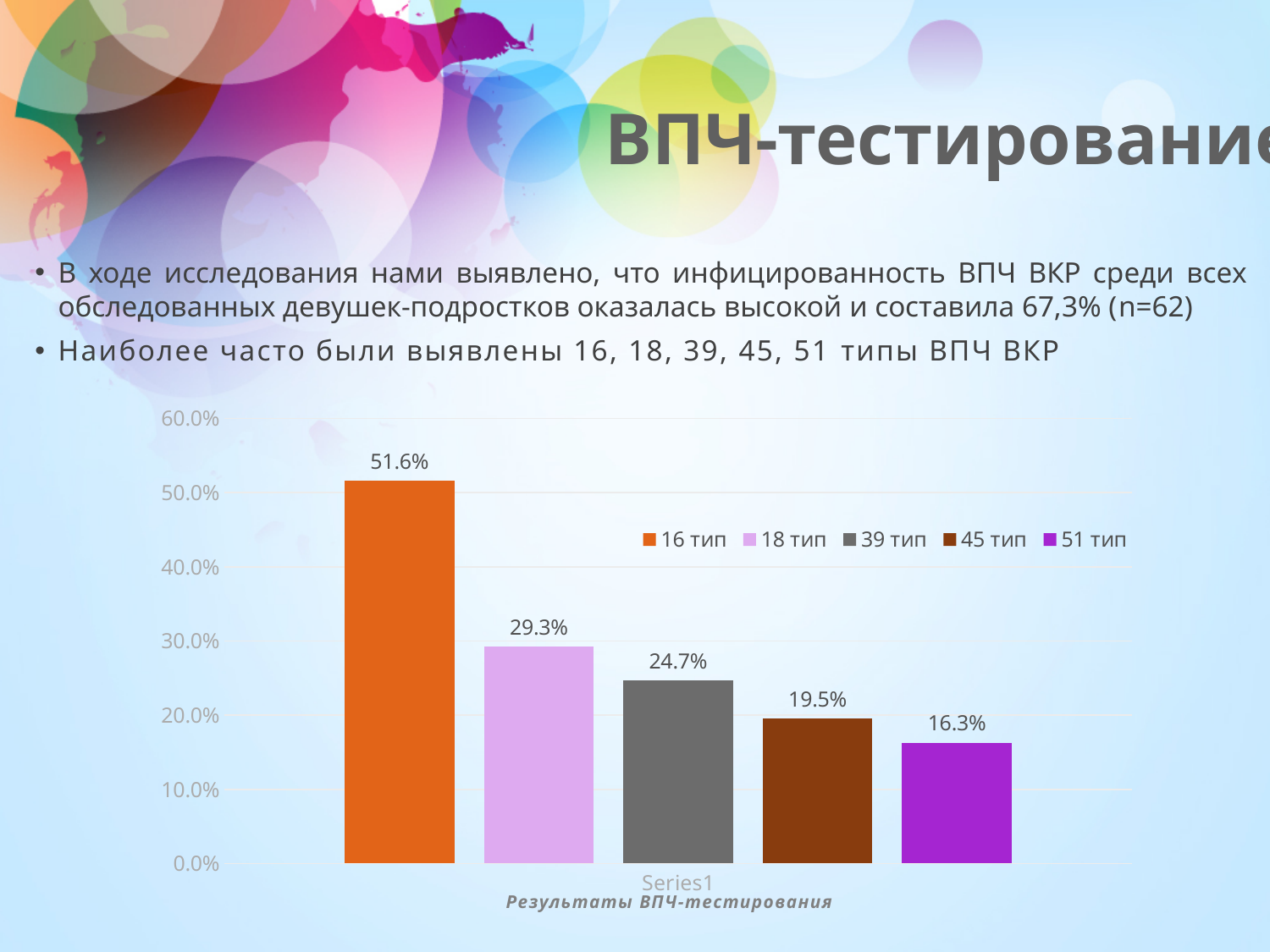
What kind of chart is shown on the slide? bar chart Which HPV type has the highest value? 16 тип How many series does the legend list? 5 Which is larger, the value for 18 тип or the value for 39 тип? 18 тип Which HPV type has the lowest value? 51 тип Is the value for 45 тип greater or less than 20.0%? less What is the difference between the values for 45 тип and 51 тип? 3.2% What is the value for 16 тип? 51.6% What is the difference between the values for 16 тип and 18 тип? 22.3% What colour is the bar for 16 тип? orange What is the value for 51 тип? 16.3% What is the value for 39 тип? 24.7%